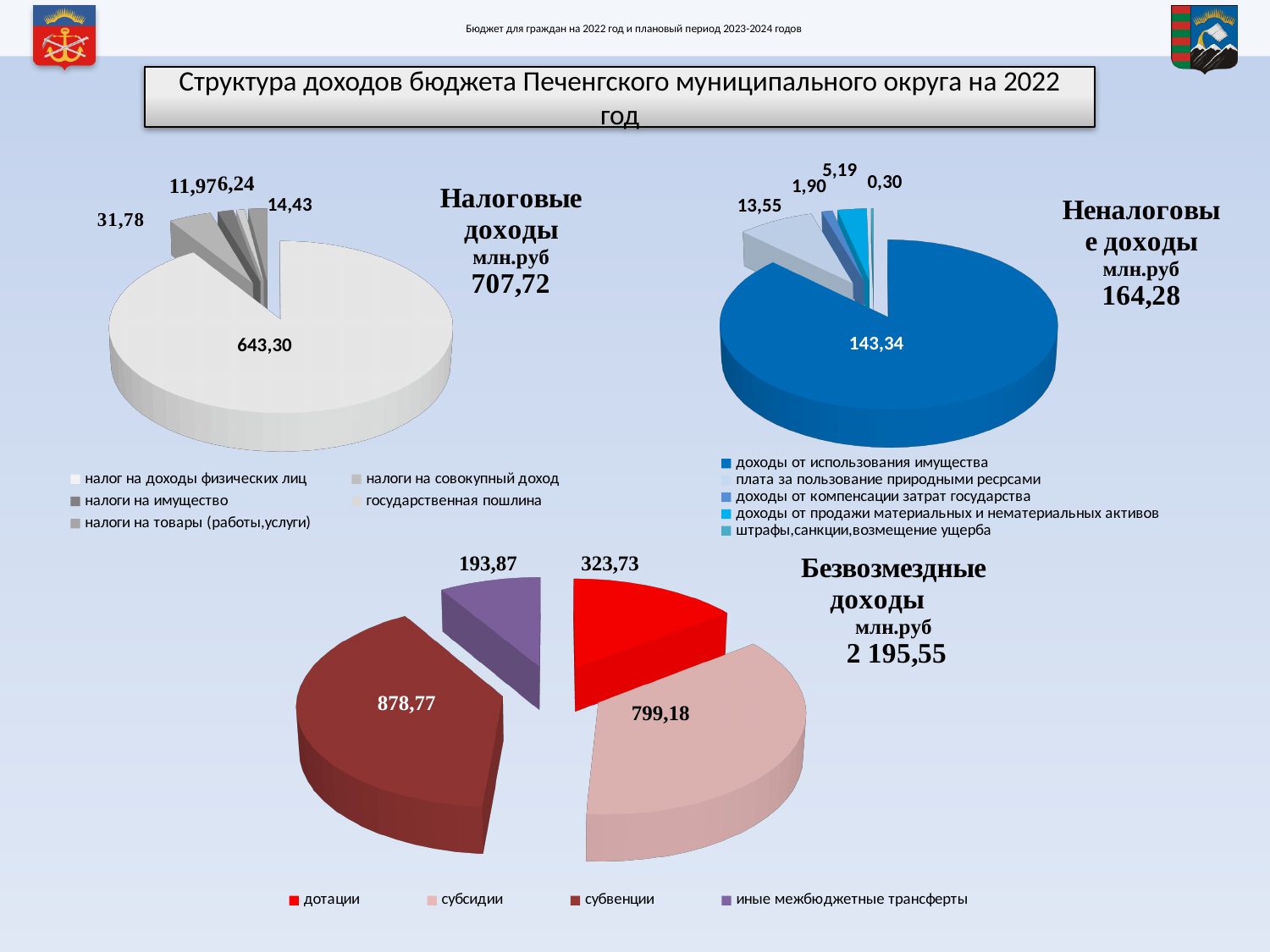
In the 'Безвозмездные доходы' chart, which category has the smallest slice? иные межбюджетные трансферты In the 'Безвозмездные доходы' chart, what is the value for дотации? 323,73 How many categories does the legend of the 'Неналоговые доходы' chart list? 5 What total (in млн.руб) is shown next to the 'Безвозмездные доходы' chart? 2 195,55 In the 'Безвозмездные доходы' chart, what is the value for субвенции? 878,77 In the 'Безвозмездные доходы' chart, which category has the largest slice? субвенции How many slices does the 'Безвозмездные доходы' pie chart have? 4 In the 'Налоговые доходы' chart, what is the value for налог на доходы физических лиц? 643,30 In the 'Неналоговые доходы' chart, what is the value for доходы от использования имущества? 143,34 In the 'Безвозмездные доходы' chart, what is the difference between субвенции and субсидии? 79,59 What type of chart is used for 'Налоговые доходы'? pie chart In the 'Безвозмездные доходы' chart, which is larger: субсидии or дотации? субсидии